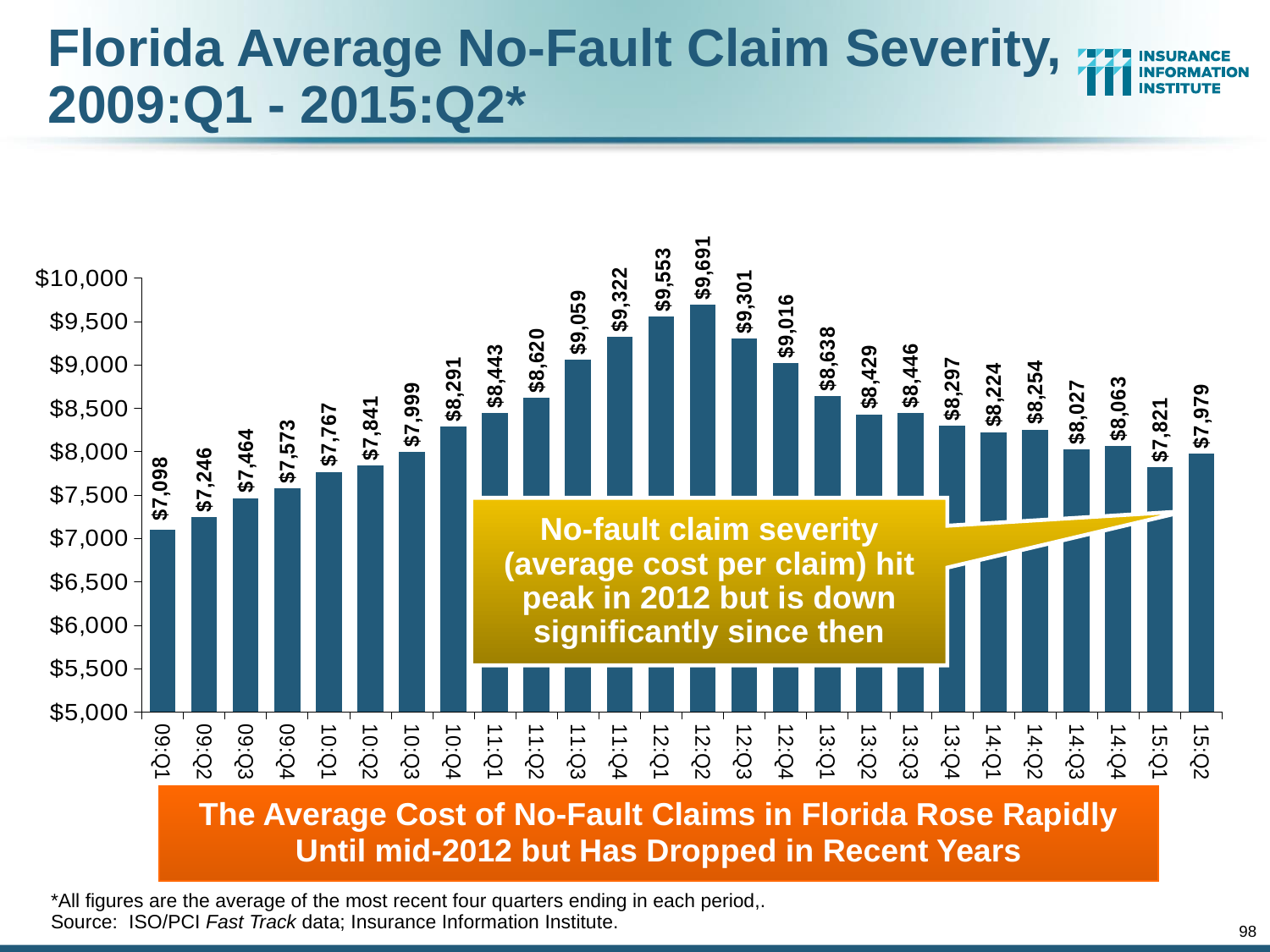
Which period has the highest average no-fault claim severity? 12:Q2 What is the average no-fault claim severity for 13:Q1? $8,638 Which is larger, the claim severity for 11:Q4 or for 12:Q4? 11:Q4 What kind of chart is shown on the slide? Bar chart What is the average no-fault claim severity for 15:Q2? $7,979 What is the difference between the claim severity in 12:Q2 and in 09:Q1? $2,593 Do the values rise or fall from 12:Q2 to 15:Q1? Fall What is the difference between the claim severity in 15:Q2 and in 15:Q1? $158 How many quarterly periods are plotted in the chart? 26 What is the average no-fault claim severity for 09:Q1? $7,098 What is the average no-fault claim severity for 12:Q2? $9,691 Which period has the lowest average no-fault claim severity? 09:Q1